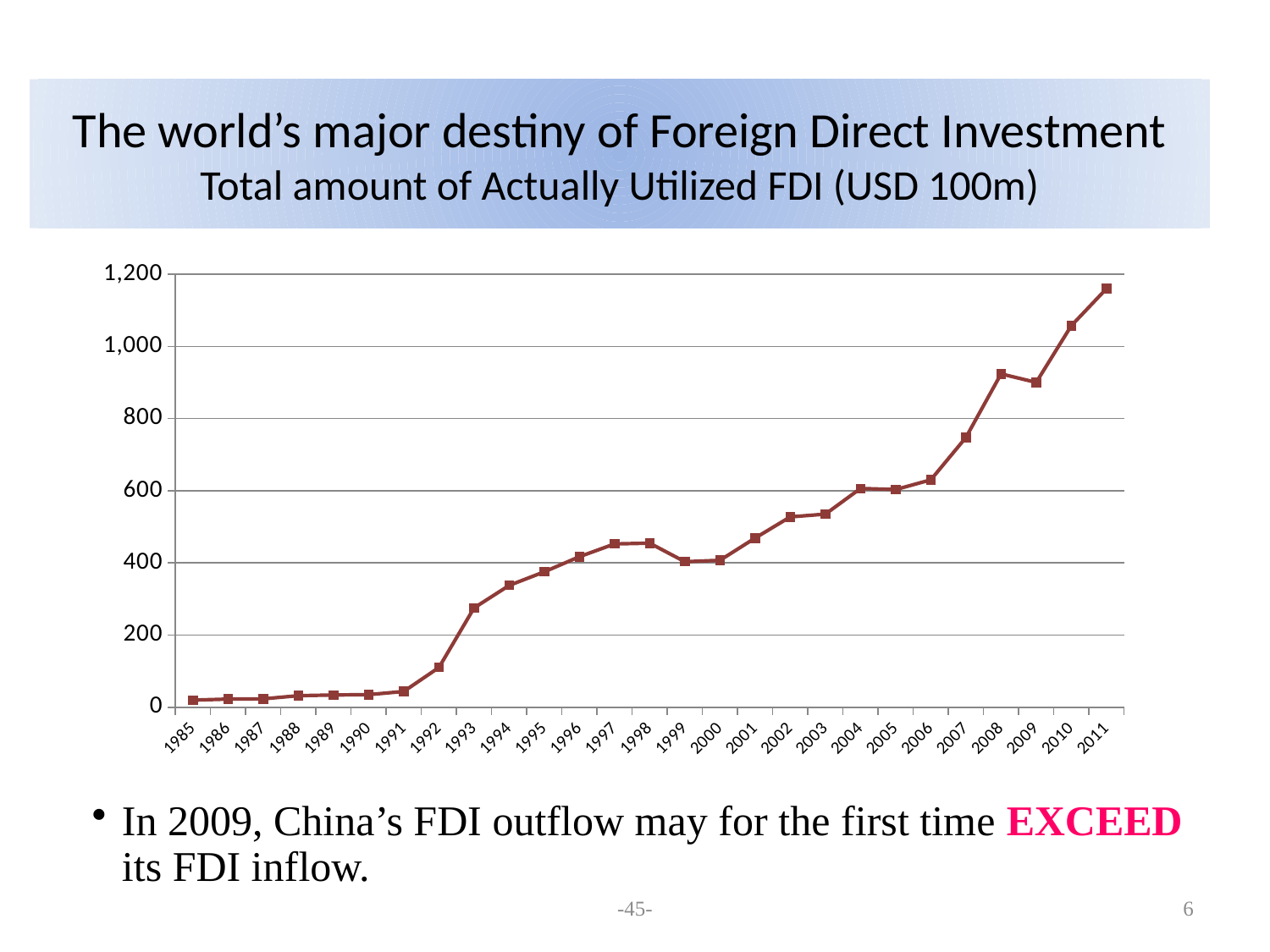
How many years are plotted along the x axis? 27 Is the value for 2007 greater or less than 800? less What kind of chart is shown on the slide? line chart Which is larger, the value for 2008 or the value for 2009? 2008 Is the value for 2011 greater or less than 1,000? greater What unit is given in the slide title for the FDI amounts? USD 100m Do the values generally rise or fall from 1985 to 2011? rise Is the value for 2003 greater or less than 600? less Which year has the highest value? 2011